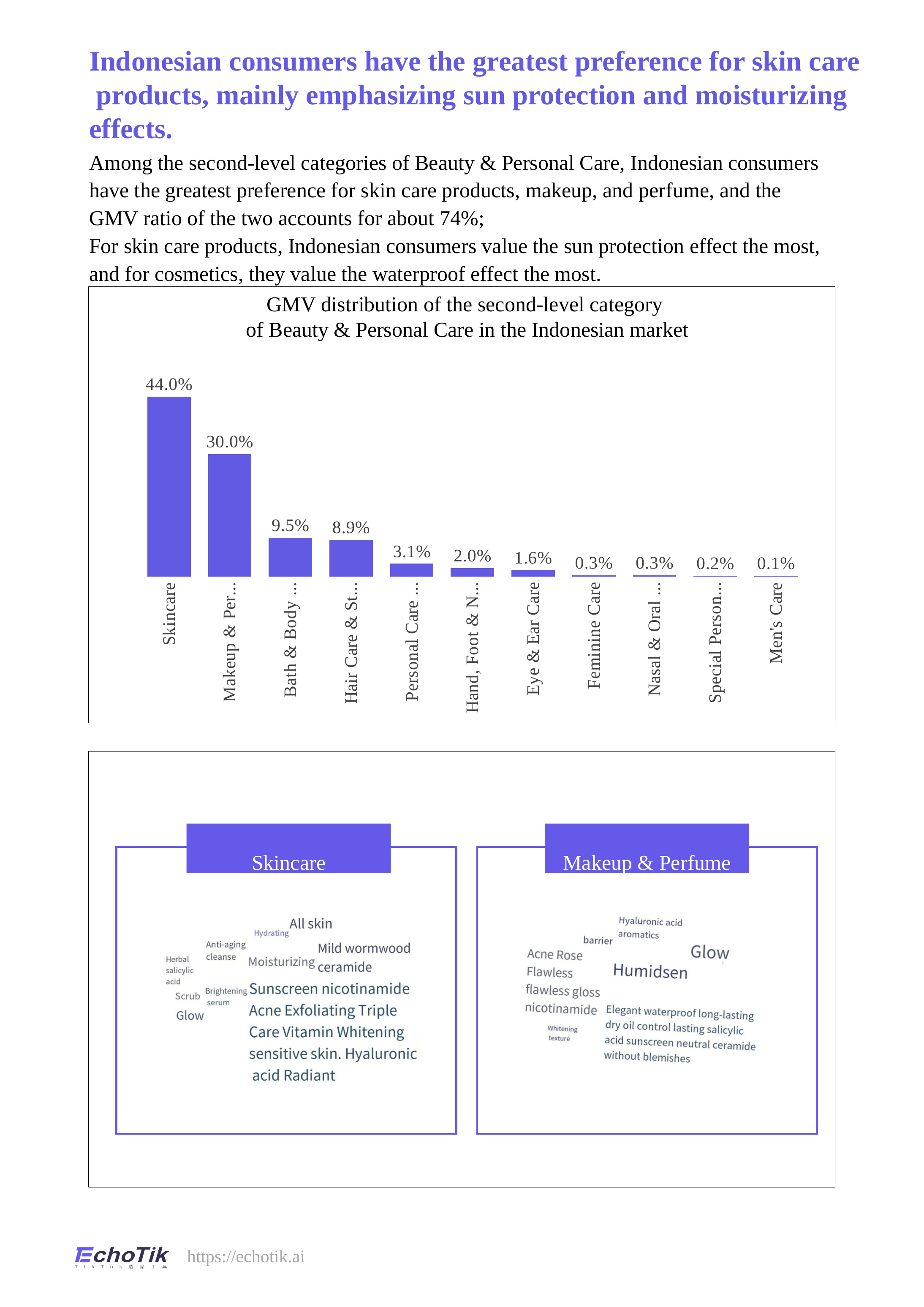
Which has a larger GMV share, Feminine Care or Men's Care? Feminine Care What is the GMV share for Skincare in the chart? 44.0% What is the difference between the GMV share of Skincare (44.0%) and the second bar labelled 'Makeup & Per...' (30.0%)? 14.0% What is the GMV share for Feminine Care? 0.3% Which category has the highest GMV share in the chart? Skincare What is the GMV share for Men's Care? 0.1% What type of chart is used to show the GMV distribution? Bar chart Do the values rise or fall from left to right along the x axis of the chart? Fall What is the difference between the GMV share of Skincare and that of Eye & Ear Care? 42.4% Which category has the lowest GMV share in the chart? Men's Care What is the GMV share for Eye & Ear Care? 1.6% How many categories are shown in the bar chart? 11